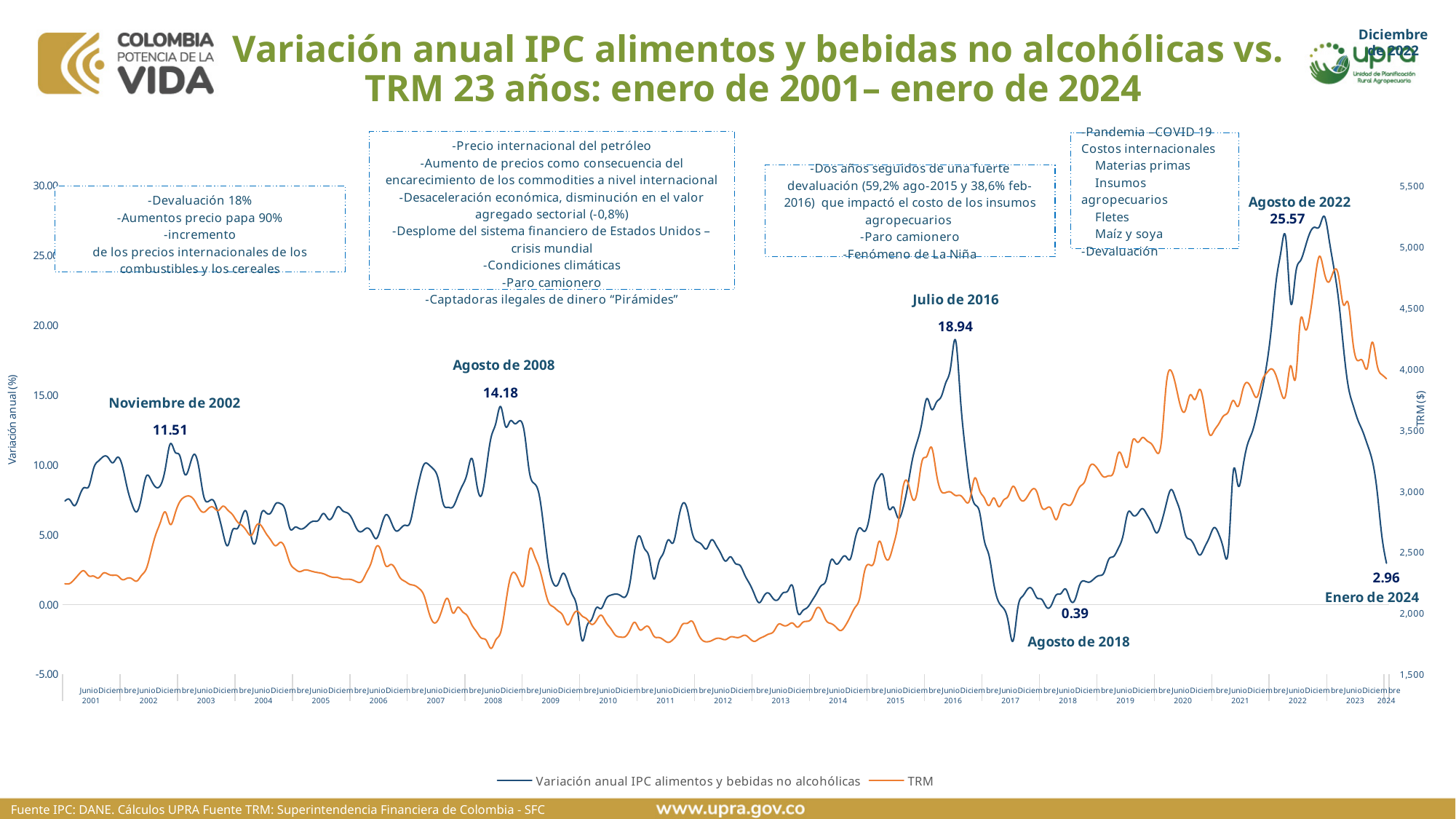
What value is labelled for Agosto de 2018 on the IPC line? 0.39 What type of chart is shown on the slide? line chart How many series does the legend list? 2 What is the difference between the labelled IPC values for Agosto de 2022 and Julio de 2016? 6.63 Which labelled IPC value is larger, Agosto de 2008 or Noviembre de 2002? Agosto de 2008 What value is labelled for Noviembre de 2002 on the IPC line? 11.51 What is the labelled IPC annual variation for Enero de 2024? 2.96 Which labelled point on the IPC line has the highest value? Agosto de 2022 What was the annual variation of the IPC for food and non-alcoholic beverages in August 2022? 25.57 Which series is drawn in orange according to the legend? TRM What was the annual variation of the IPC for food and non-alcoholic beverages in July 2016? 18.94 Which labelled point on the IPC line has the lowest value? Agosto de 2018